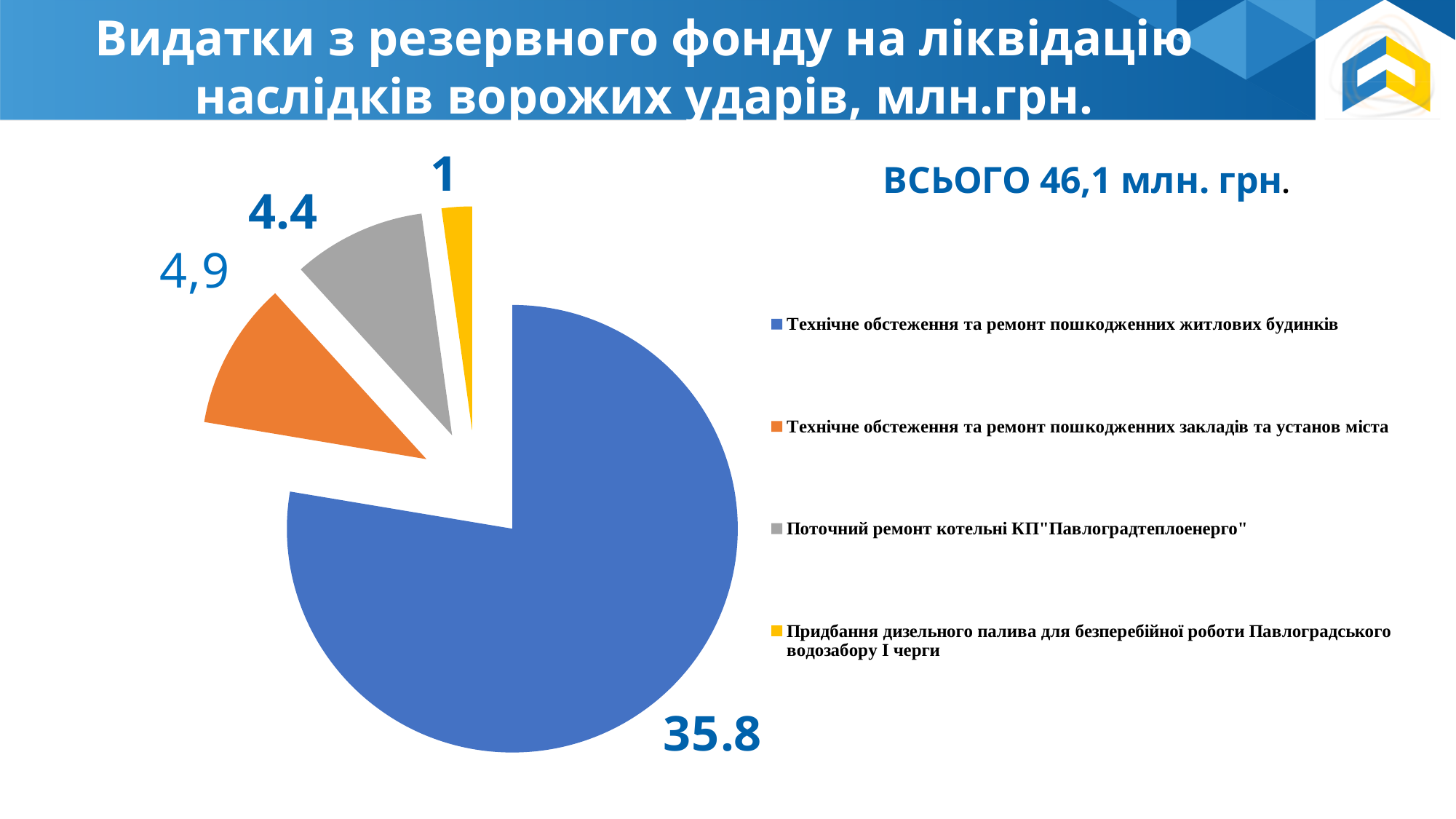
What is the value for "Поточний ремонт котельні КП"Павлоградтеплоенерго""? 4.4 What type of chart is shown on the slide? pie chart Which is larger: the value for "Технічне обстеження та ремонт пошкодженних закладів та установ міста" or the value for "Поточний ремонт котельні КП"Павлоградтеплоенерго""? Технічне обстеження та ремонт пошкодженних закладів та установ міста What is the value for "Технічне обстеження та ремонт пошкодженних закладів та установ міста"? 4,9 What colour is the slice for "Поточний ремонт котельні КП"Павлоградтеплоенерго""? gray Which category has the smallest slice of the pie? Придбання дизельного палива для безперебійної роботи Павлоградського водозабору І черги What is the difference between the value for "Технічне обстеження та ремонт пошкодженних житлових будинків" and the value for "Придбання дизельного палива для безперебійної роботи Павлоградського водозабору І черги"? 34.8 What is the value for "Придбання дизельного палива для безперебійної роботи Павлоградського водозабору І черги"? 1 What is the value for "Технічне обстеження та ремонт пошкодженних житлових будинків"? 35.8 How many categories does the pie chart have? 4 What total amount is stated on the slide for the expenditures? 46,1 млн. грн. Which category has the largest slice of the pie? Технічне обстеження та ремонт пошкодженних житлових будинків